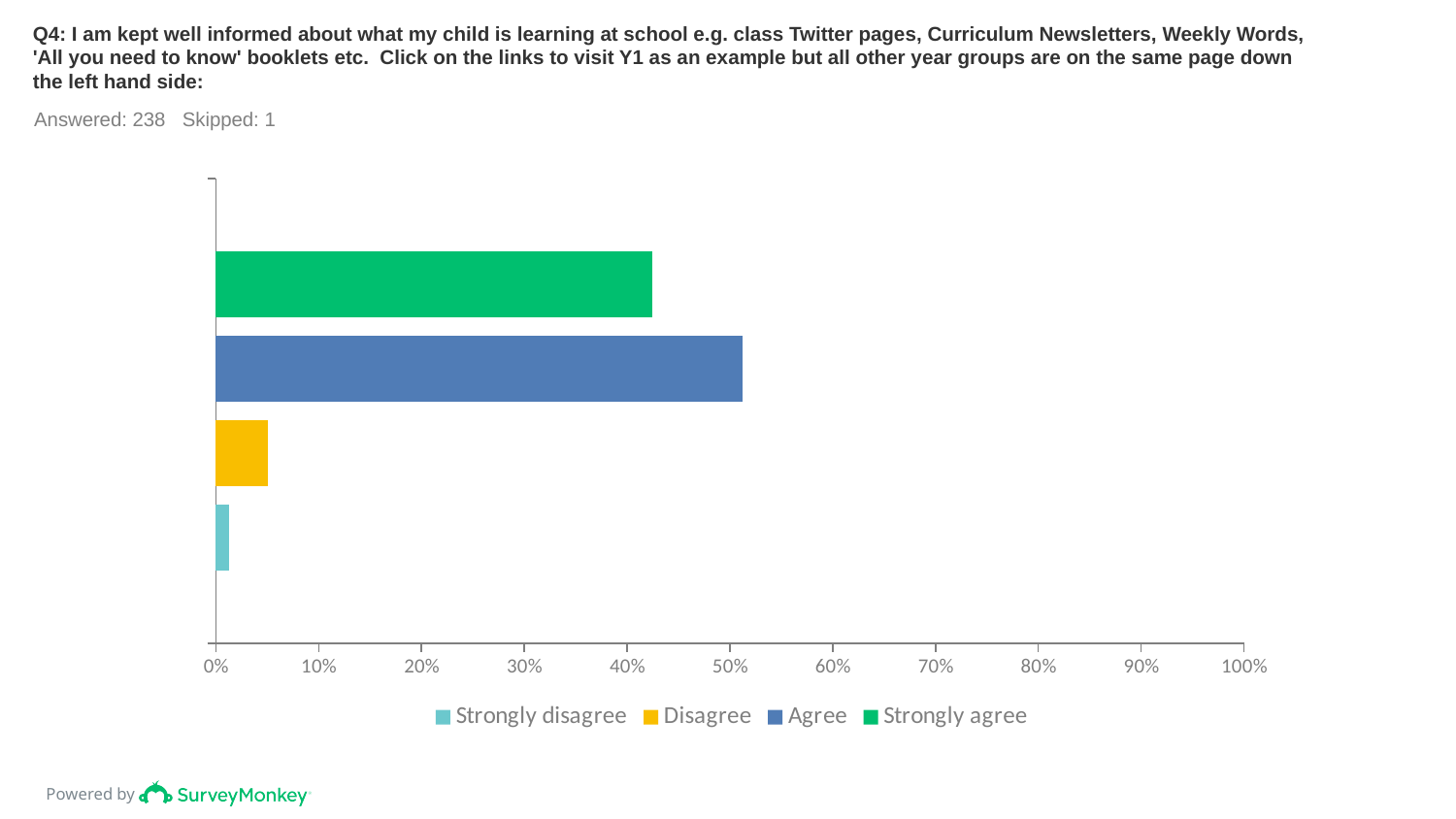
What kind of chart is shown on the slide? bar chart What colour is the bar for Strongly agree? green Is the value for Strongly agree greater or less than 40%? greater How many respondents answered this question according to the slide? 238 Which is larger, the value for Disagree or the value for Strongly disagree? Disagree Which response option has the highest value? Agree Is the value for Disagree greater or less than 10%? less Is the value for Agree greater or less than 50%? greater Which is larger, the value for Agree or the value for Strongly agree? Agree How many entries does the legend list? 4 Which response option has the lowest value? Strongly disagree How many bars are plotted in the chart? 4